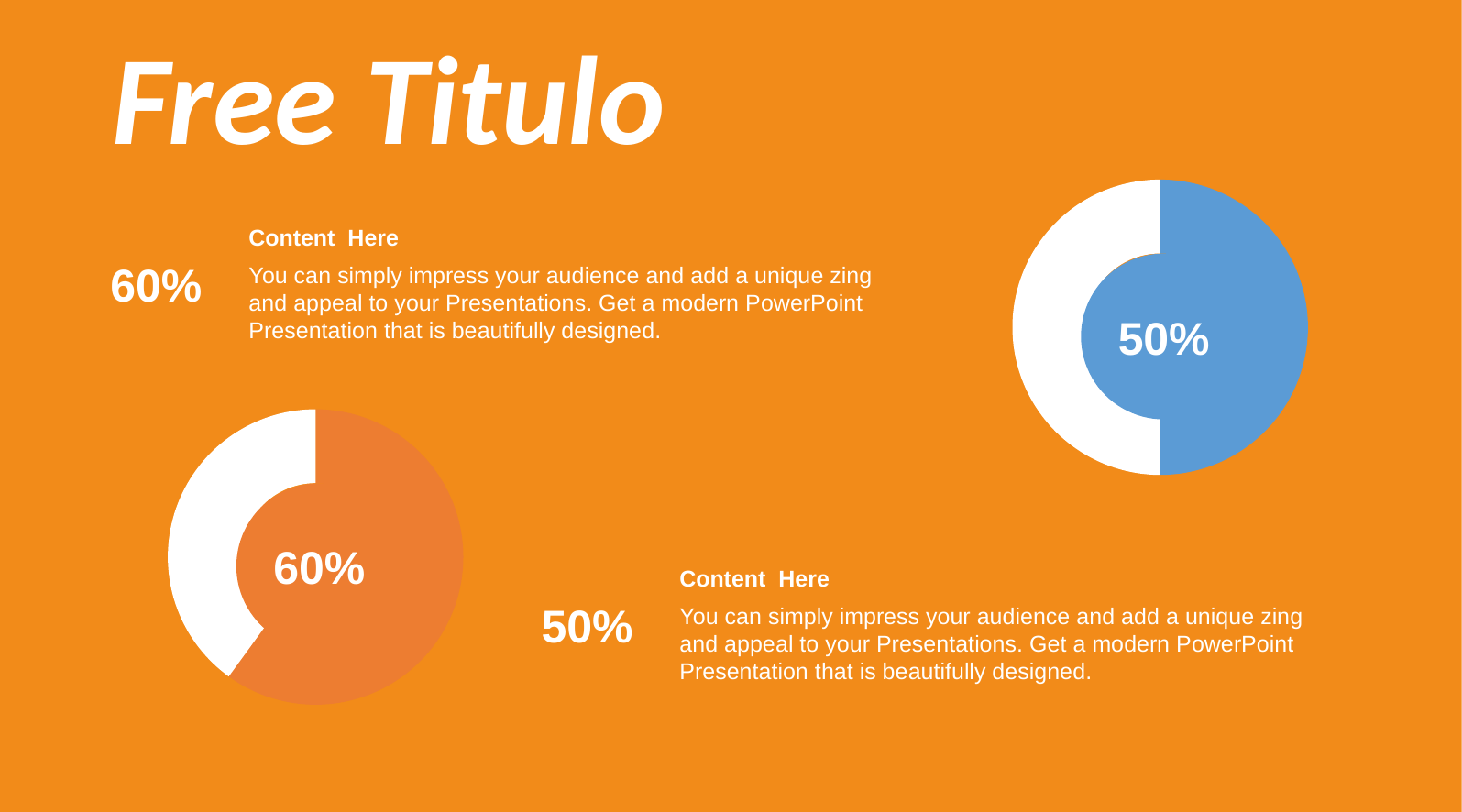
How many slices does the top-right pie chart have? 2 What kind of chart is shown at the top right of the slide? doughnut chart What is the difference between the percentage shown in the bottom-left chart and the percentage shown in the top-right chart? 10% How many pie charts are on the slide? 2 Which chart shows the larger percentage, the bottom-left orange chart or the top-right blue chart? the bottom-left orange chart Is the percentage shown in the top-right blue pie chart greater or less than 60%? less What percentage is printed in the centre of the bottom-left orange pie chart? 60% What percentage is printed in the centre of the top-right blue pie chart? 50% What colour is the coloured slice of the top-right pie chart? blue How many slices does the bottom-left pie chart have? 2 What kind of chart is shown at the bottom left of the slide? doughnut chart What colour is the coloured slice of the bottom-left pie chart? orange